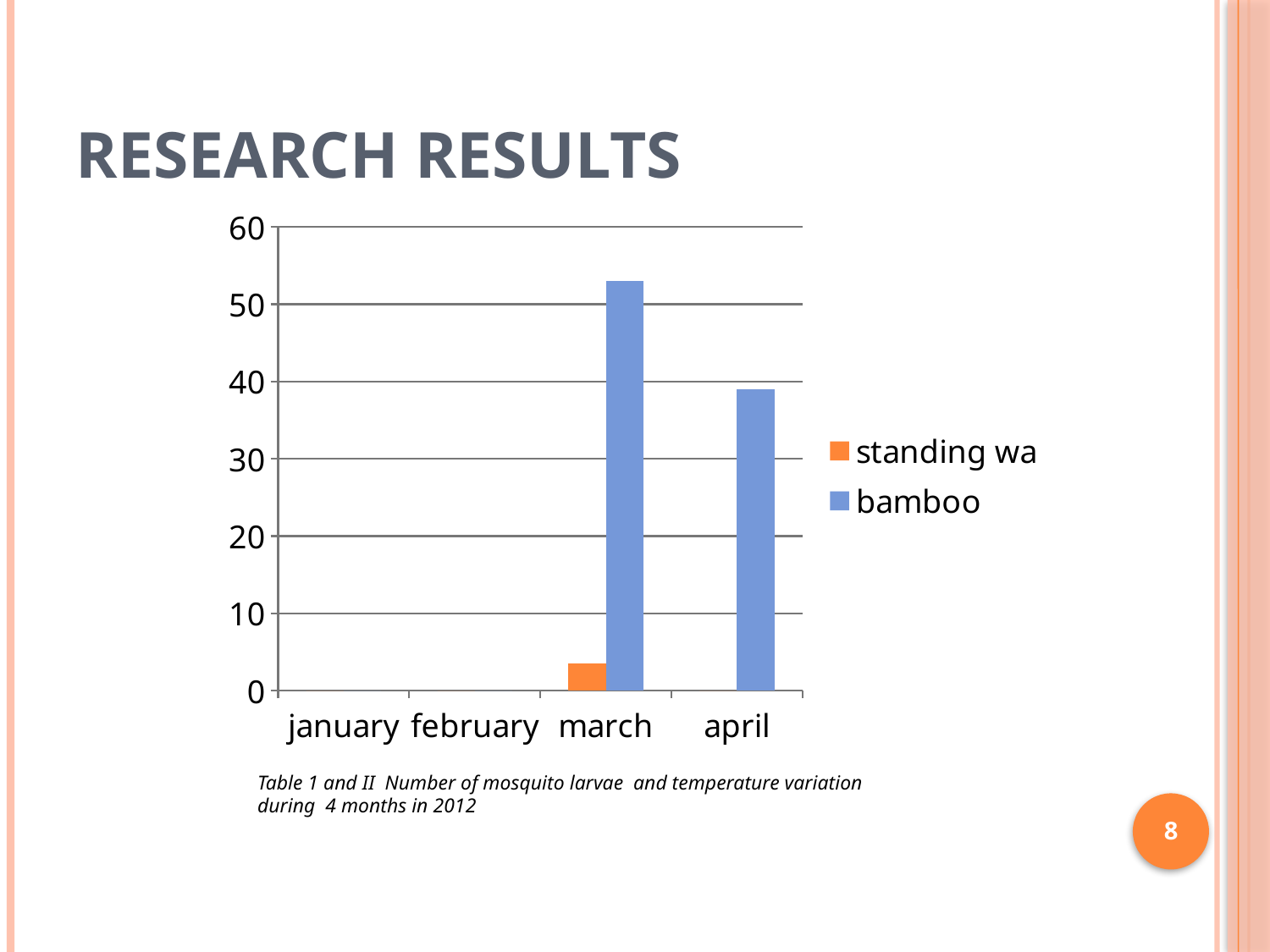
How many series does the legend list? 2 Which is larger, the bamboo value for march or the bamboo value for april? march Is the bamboo value for march greater or less than 50? greater What is the first entry listed in the legend? standing wa What kind of chart is shown on the slide? bar chart How many categories are shown on the x axis? 4 What colour represents the bamboo series? blue Is the bamboo value for april greater or less than 30? greater Which month has the highest bamboo value? march In march, which series has the larger value, standing wa or bamboo? bamboo Is the standing wa value for march greater or less than 10? less